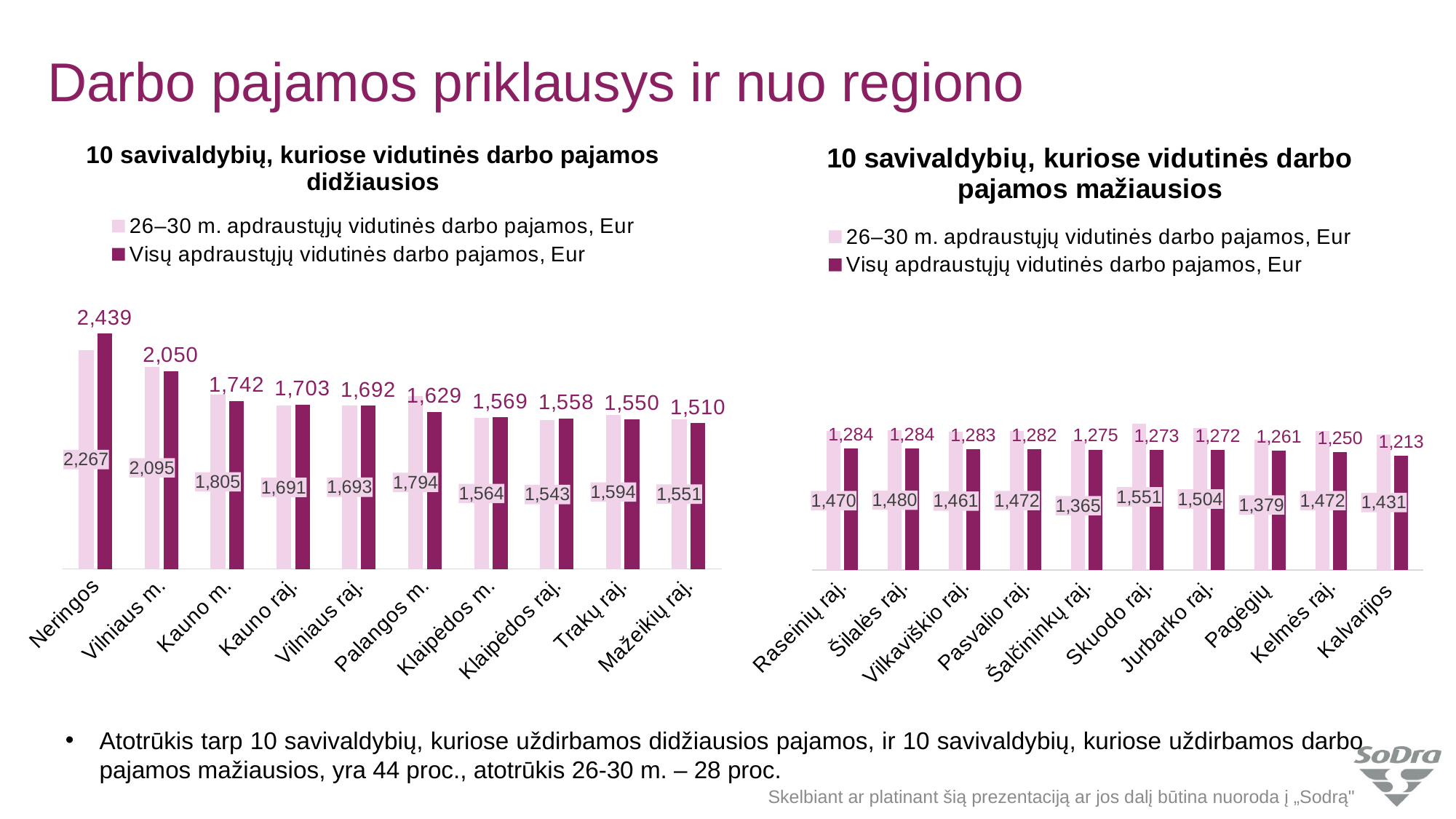
In the right chart (10 savivaldybių, kuriose vidutinės darbo pajamos mažiausios), what is the difference between the 26–30 m. value and the Visų apdraustųjų value for Jurbarko raj.? 232 How many municipalities are shown in the right chart (10 savivaldybių, kuriose vidutinės darbo pajamos mažiausios)? 10 In the left chart (10 savivaldybių, kuriose vidutinės darbo pajamos didžiausios), what is the value of '26–30 m. apdraustųjų vidutinės darbo pajamos, Eur' for Palangos m.? 1,794 In the left chart (10 savivaldybių, kuriose vidutinės darbo pajamos didžiausios), what is the difference between the 'Visų apdraustųjų' values for Neringos and Vilniaus m.? 389 In the right chart (10 savivaldybių, kuriose vidutinės darbo pajamos mažiausios), what is the value of 'Visų apdraustųjų vidutinės darbo pajamos, Eur' for Kalvarijos? 1,213 In the left chart (10 savivaldybių, kuriose vidutinės darbo pajamos didžiausios), which is larger for Palangos m.: the 26–30 m. value or the Visų apdraustųjų value? 26–30 m. value (1,794) How many series does the legend of the left chart (10 savivaldybių, kuriose vidutinės darbo pajamos didžiausios) list? 2 In the left chart (10 savivaldybių, kuriose vidutinės darbo pajamos didžiausios), which municipality has the highest 'Visų apdraustųjų vidutinės darbo pajamos, Eur'? Neringos In the right chart (10 savivaldybių, kuriose vidutinės darbo pajamos mažiausios), which municipality has the lowest '26–30 m. apdraustųjų vidutinės darbo pajamos, Eur'? Šalčininkų raj. What type of chart is the left chart (10 savivaldybių, kuriose vidutinės darbo pajamos didžiausios)? Bar chart In the right chart (10 savivaldybių, kuriose vidutinės darbo pajamos mažiausios), what is the value of '26–30 m. apdraustųjų vidutinės darbo pajamos, Eur' for Skuodo raj.? 1,551 In the left chart (10 savivaldybių, kuriose vidutinės darbo pajamos didžiausios), what is the value of 'Visų apdraustųjų vidutinės darbo pajamos, Eur' for Neringos? 2,439